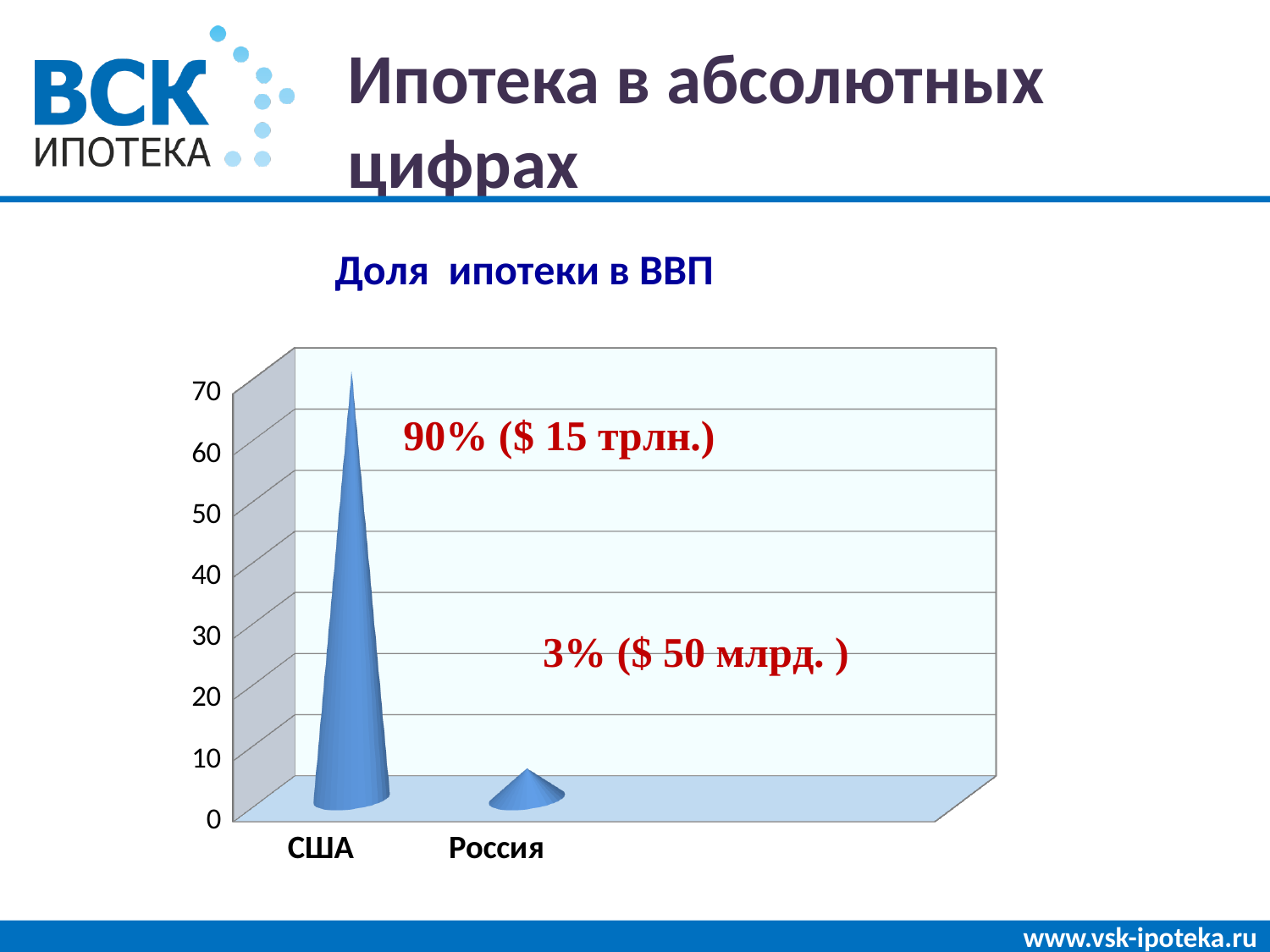
How many categories are shown on the x axis of the chart? 2 What is the title of the chart on the slide? Доля ипотеки в ВВП Which has the larger value, США or Россия? США What percentage label is printed for США on the chart? 90% Which category has the lowest value in the chart? Россия What kind of chart is shown on the slide? bar chart What percentage label is printed for Россия on the chart? 3% Is the value for США greater or less than 60? greater Is the value for Россия greater or less than 10? less Do the values rise or fall moving from США to Россия along the x axis? fall Which category has the highest value in the chart? США What absolute amount is shown in parentheses next to the 90% label for США? $ 15 трлн.